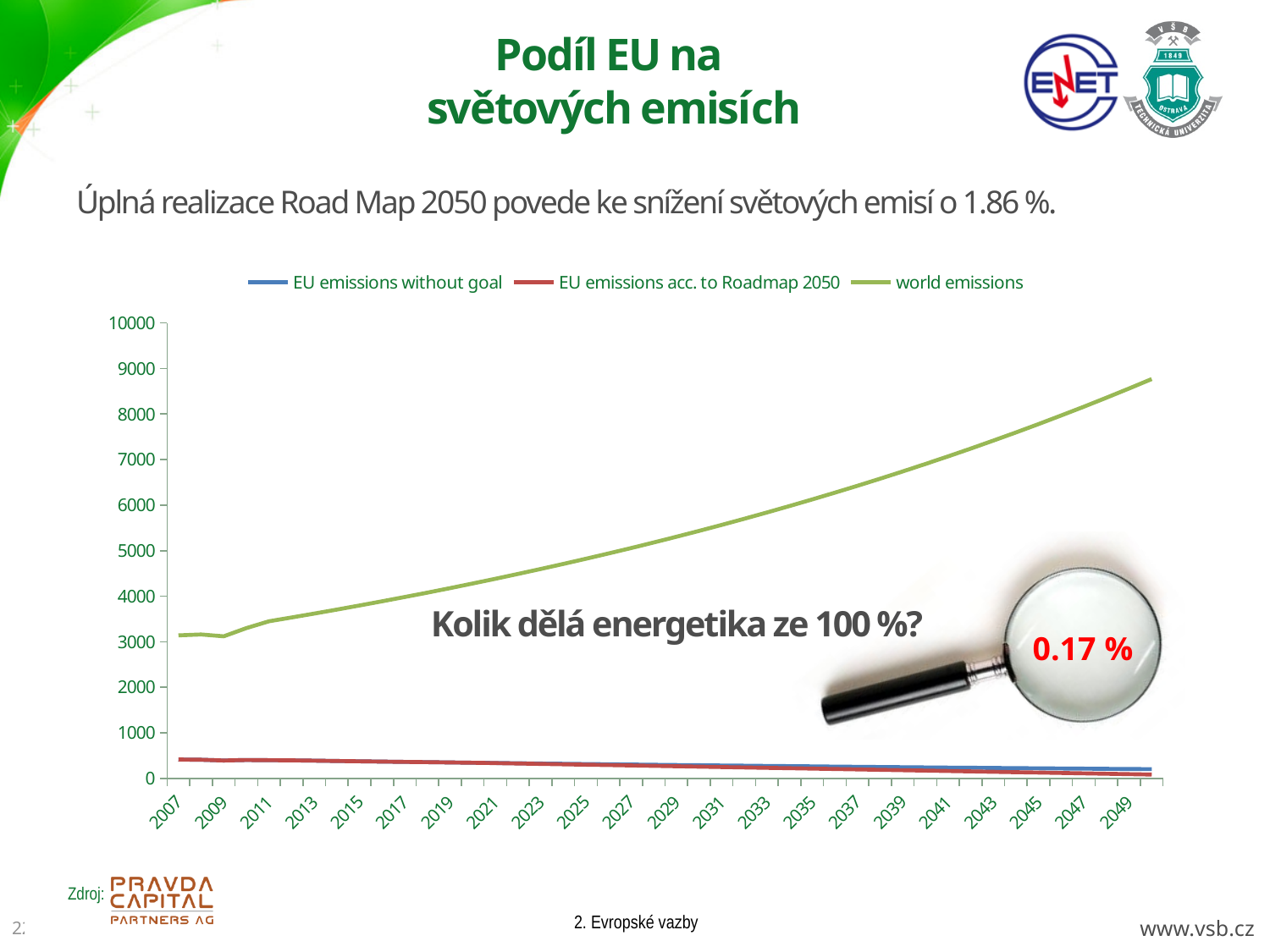
Do the EU emissions acc. to Roadmap 2050 rise or fall from 2007 to 2049? fall In 2049, which is larger: EU emissions without goal or EU emissions acc. to Roadmap 2050? EU emissions without goal Is the value for EU emissions without goal in 2007 greater or less than 1000? less Which series has the lowest value at the right end of the chart (2049)? EU emissions acc. to Roadmap 2050 What colour is the line for world emissions? green How many series does the chart legend list? 3 Do the world emissions rise or fall from 2007 to 2049? rise Which series has the highest values throughout the chart? world emissions Is the value for world emissions in 2035 greater or less than 5000? greater What kind of chart is shown on the slide? line chart Is the value for world emissions in 2049 greater or less than 8000? greater